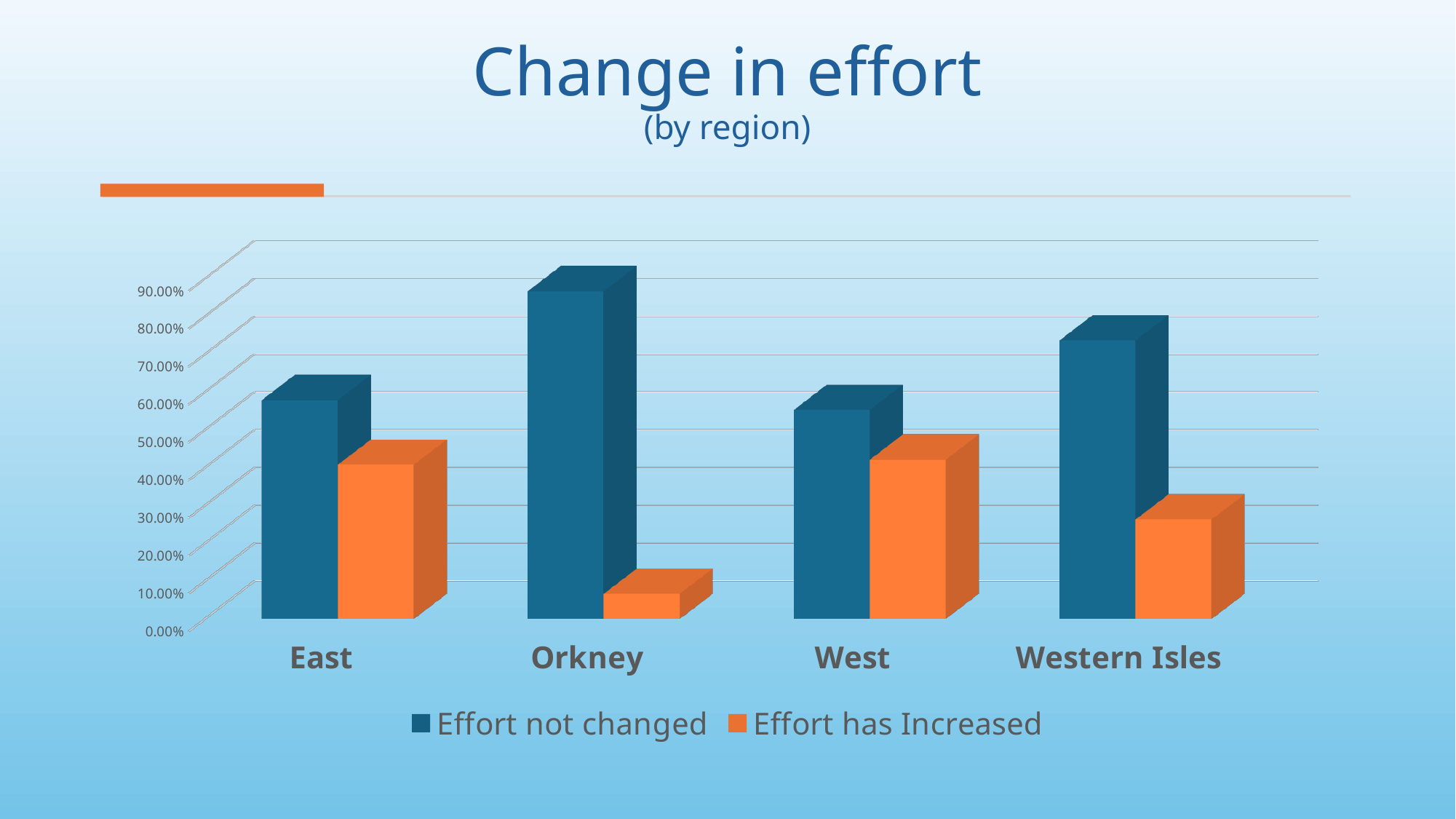
Is the 'Effort not changed' value for Orkney greater or less than 80.00%? greater How many regions are shown on the x axis of the chart? 4 Which region has the highest value for 'Effort not changed'? Orkney Which colour represents 'Effort has Increased' in the chart? orange Which region has the lowest value for 'Effort has Increased'? Orkney How many series does the chart's legend list? 2 Is the 'Effort has Increased' value for Orkney greater or less than 20.00%? less Is the 'Effort has Increased' value for Western Isles greater or less than 40.00%? less What is the title of the chart on the slide? Change in effort (by region) What kind of chart is shown on the slide? bar chart For East, which is larger: 'Effort not changed' or 'Effort has Increased'? Effort not changed